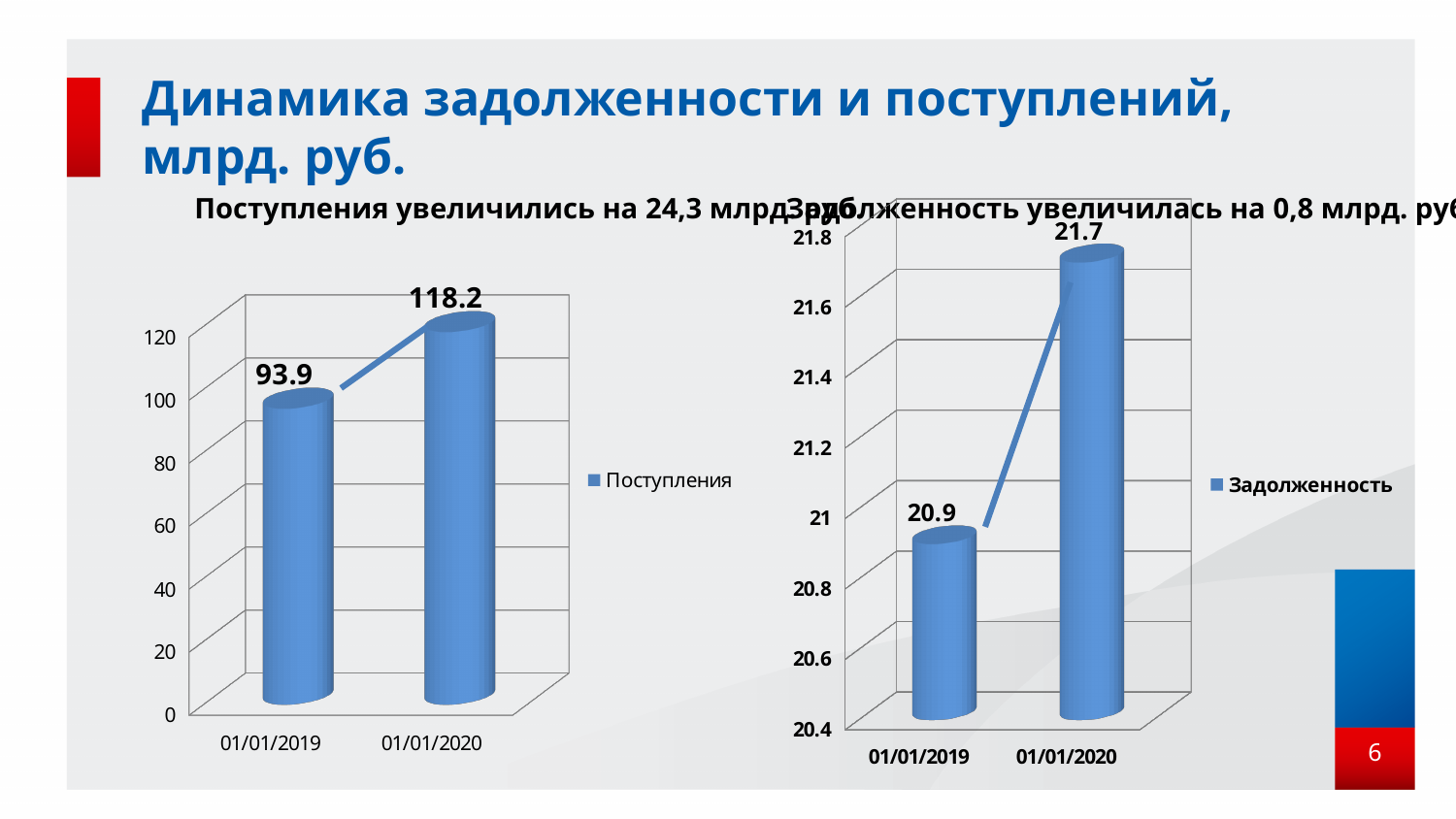
In the left chart (Поступления), by how much does the value for 01/01/2020 exceed the value for 01/01/2019? 24.3 In the right chart (Задолженность), what is the value for 01/01/2020? 21.7 In the left chart (Поступления), what is the value for 01/01/2019? 93.9 In the left chart (Поступления), what is the value for 01/01/2020? 118.2 In the right chart (Задолженность), do the values rise or fall from 01/01/2019 to 01/01/2020? rise In the left chart (Поступления), which date has the higher value? 01/01/2020 In the left chart (Поступления), is the value for 01/01/2019 greater or less than 100? less In the right chart (Задолженность), what is the difference between the 01/01/2020 and 01/01/2019 values? 0.8 What kind of chart is the left chart (Поступления)? bar chart In the right chart (Задолженность), what is the value for 01/01/2019? 20.9 How many categories are shown on the x axis of the right chart (Задолженность)? 2 In the right chart (Задолженность), which date has the lower value? 01/01/2019